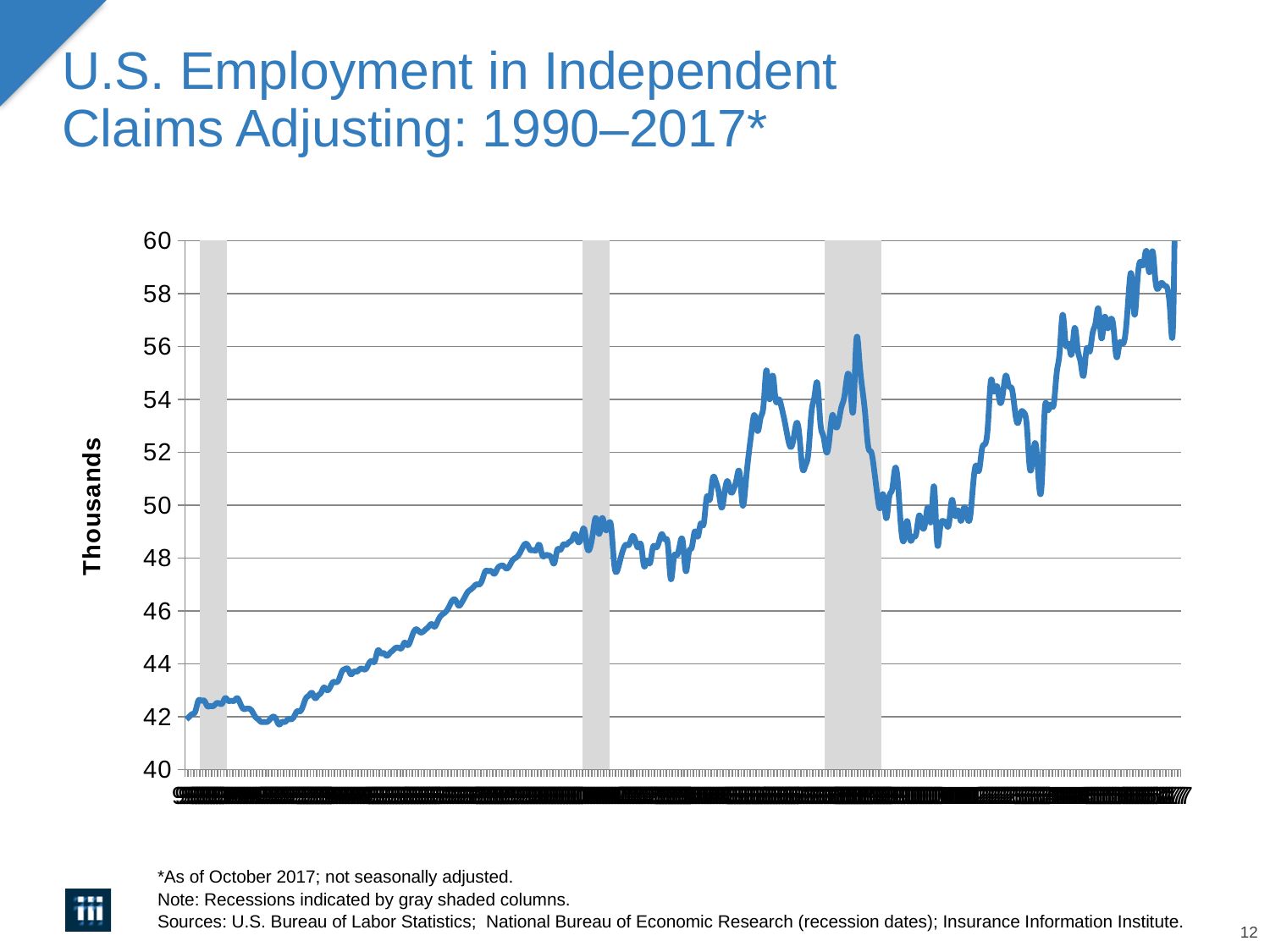
Is the lowest point of the line greater or less than 40? greater According to the note on the slide, what do the gray shaded columns indicate? Recessions What kind of chart is shown on the slide? line chart Overall, does the employment line rise or fall from the start of the series to the end? rise Which is larger, the value at the start of the series or the value at the end of the series? the end of the series What is the highest value shown on the vertical axis? 60 What is the lowest value shown on the vertical axis? 40 Is the value at the end of the series (2017) greater or less than 56? greater Is the value at the start of the series (1990) greater or less than 44? less